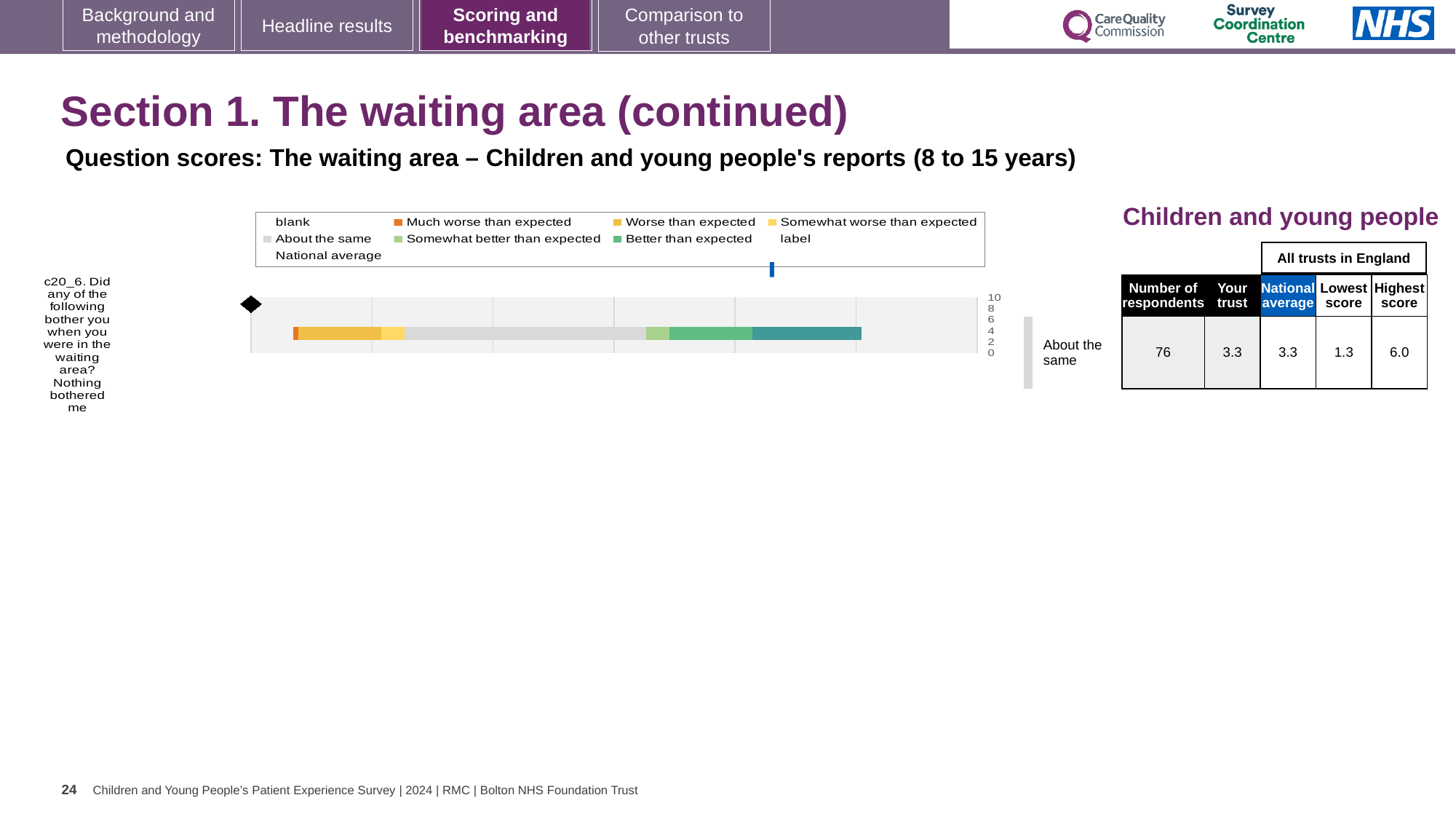
What is the question code of the item plotted in the chart? c20_6 What is the 'Your trust' score for question c20_6? 3.3 What is the number of respondents for question c20_6? 76 What is the national average score for question c20_6? 3.3 What is the difference between the highest score and the trust's score for question c20_6? 2.7 What is the highest score among all trusts in England for question c20_6? 6.0 Which legend entry is shown in orange? Much worse than expected Is the trust's score for question c20_6 higher than, lower than, or the same as the national average? the same What is the lowest score among all trusts in England for question c20_6? 1.3 What is the difference between the highest score and the lowest score for question c20_6? 4.7 How many survey questions are plotted in the chart? 1 What kind of chart is shown on the slide? bar chart